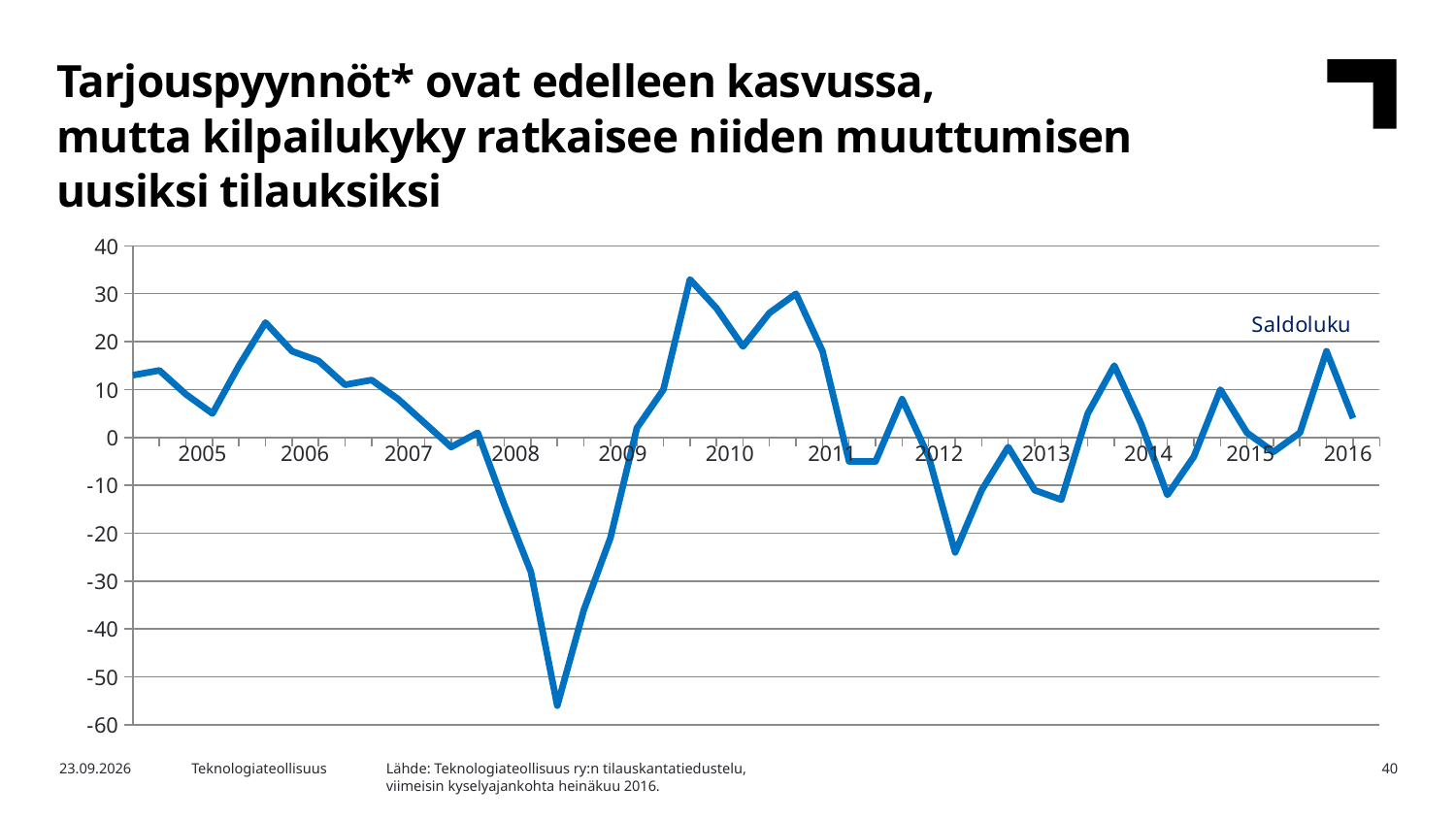
Does the line rise or fall between its 2008 low and its peak around 2009-2010? rise What is the highest value shown on the y axis? 40 Is the lowest point around 2012 greater or less than -20? less Is the value at the start of the series (2005) greater or less than 0? greater Is the lowest point of the line greater or less than -50? less Which is larger: the value at the 2008 low or the value at the 2012 low? 2012 low How many year labels are shown on the x axis? 12 What is the name of the series plotted on the chart? Saldoluku How many data series does the chart show? 1 What kind of chart is shown on the slide? line chart